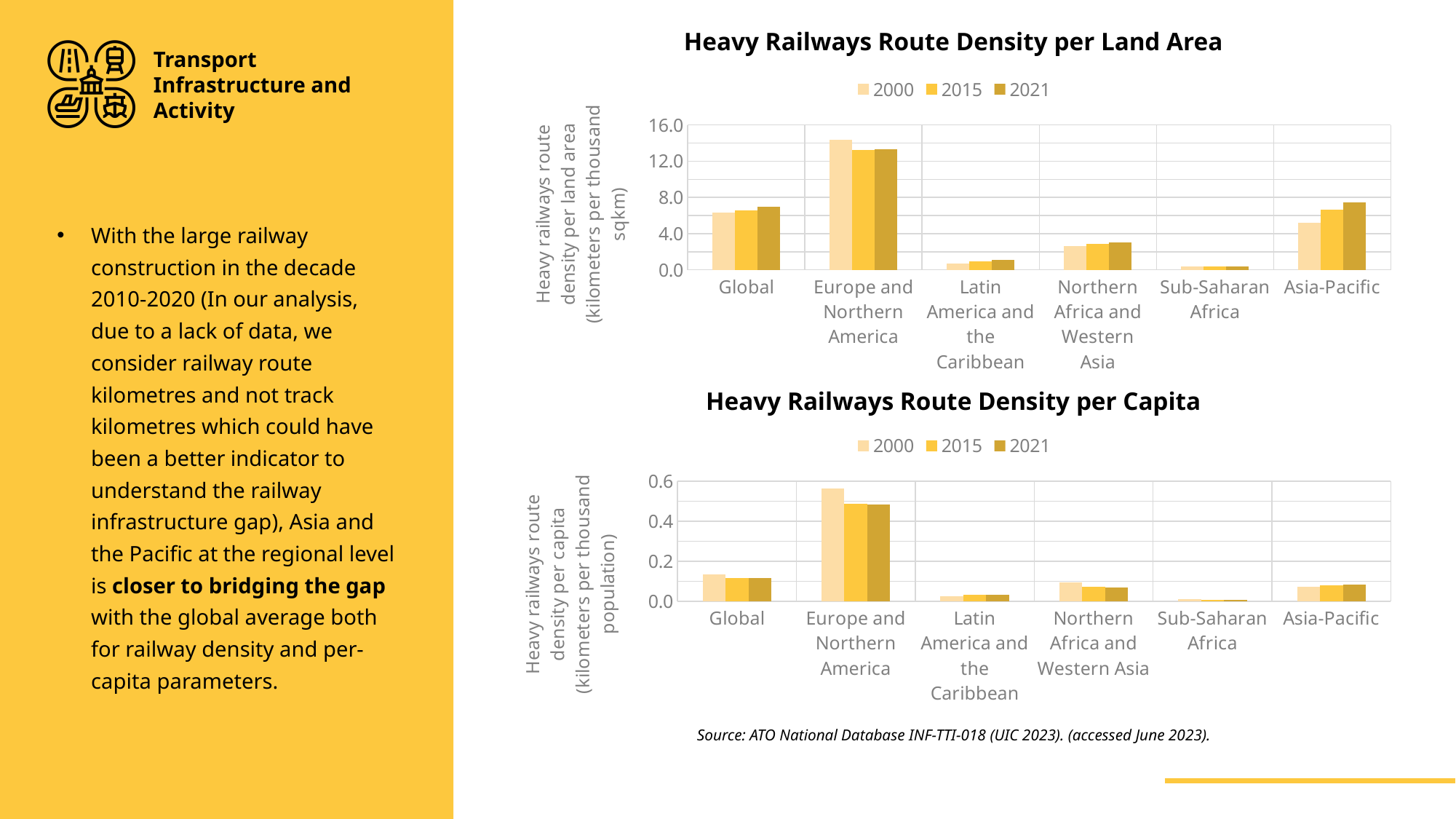
How many regions are shown on the x axis of the 'Heavy Railways Route Density per Capita' chart? 6 In the 'Heavy Railways Route Density per Land Area' chart, which region has the lowest route density in 2021? Sub-Saharan Africa What kind of chart is the 'Heavy Railways Route Density per Capita' chart? bar chart In the 'Heavy Railways Route Density per Capita' chart, which region has the highest route density per capita in 2021? Europe and Northern America In the 'Heavy Railways Route Density per Land Area' chart, is the 2021 value for Global greater or less than 8.0? less How many series does the legend of the 'Heavy Railways Route Density per Land Area' chart list? 3 What are the three years listed in the legend of the 'Heavy Railways Route Density per Capita' chart? 2000, 2015, 2021 In the 'Heavy Railways Route Density per Land Area' chart, do the values for Asia-Pacific rise or fall from 2000 to 2021? rise In the 'Heavy Railways Route Density per Land Area' chart, which is larger in 2021: Asia-Pacific or Northern Africa and Western Asia? Asia-Pacific In the 'Heavy Railways Route Density per Land Area' chart, is the 2000 value for Europe and Northern America greater or less than 12.0? greater In the 'Heavy Railways Route Density per Land Area' chart, which region has the highest route density in 2000? Europe and Northern America In the 'Heavy Railways Route Density per Capita' chart, is the 2000 value for Europe and Northern America greater or less than 0.4? greater